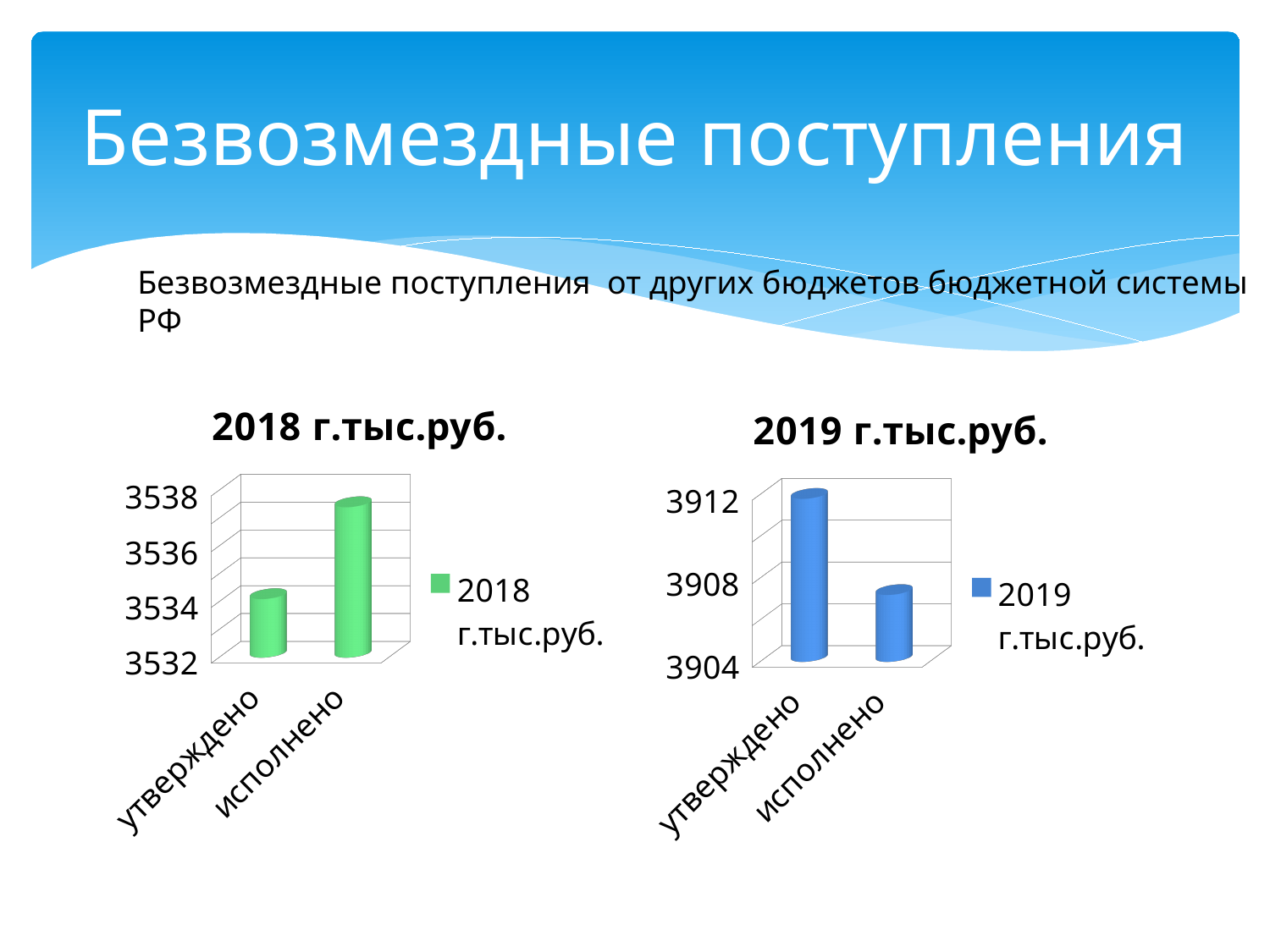
In the "2019 г.тыс.руб." chart, which is larger, утверждено or исполнено? утверждено In the "2019 г.тыс.руб." chart, is the value for исполнено greater or less than 3912? less In the "2018 г.тыс.руб." chart, is the value for утверждено greater or less than 3536? less How many categories are shown in the "2018 г.тыс.руб." chart? 2 What kind of chart is the "2018 г.тыс.руб." chart? bar chart In the "2019 г.тыс.руб." chart, which category has the lower value? исполнено How many series does the legend of the "2019 г.тыс.руб." chart list? 1 In the "2019 г.тыс.руб." chart, is the value for утверждено greater or less than 3908? greater What colour are the bars in the "2019 г.тыс.руб." chart? blue What is the legend entry of the "2018 г.тыс.руб." chart? 2018 г.тыс.руб. In the "2018 г.тыс.руб." chart, which category has the higher value? исполнено